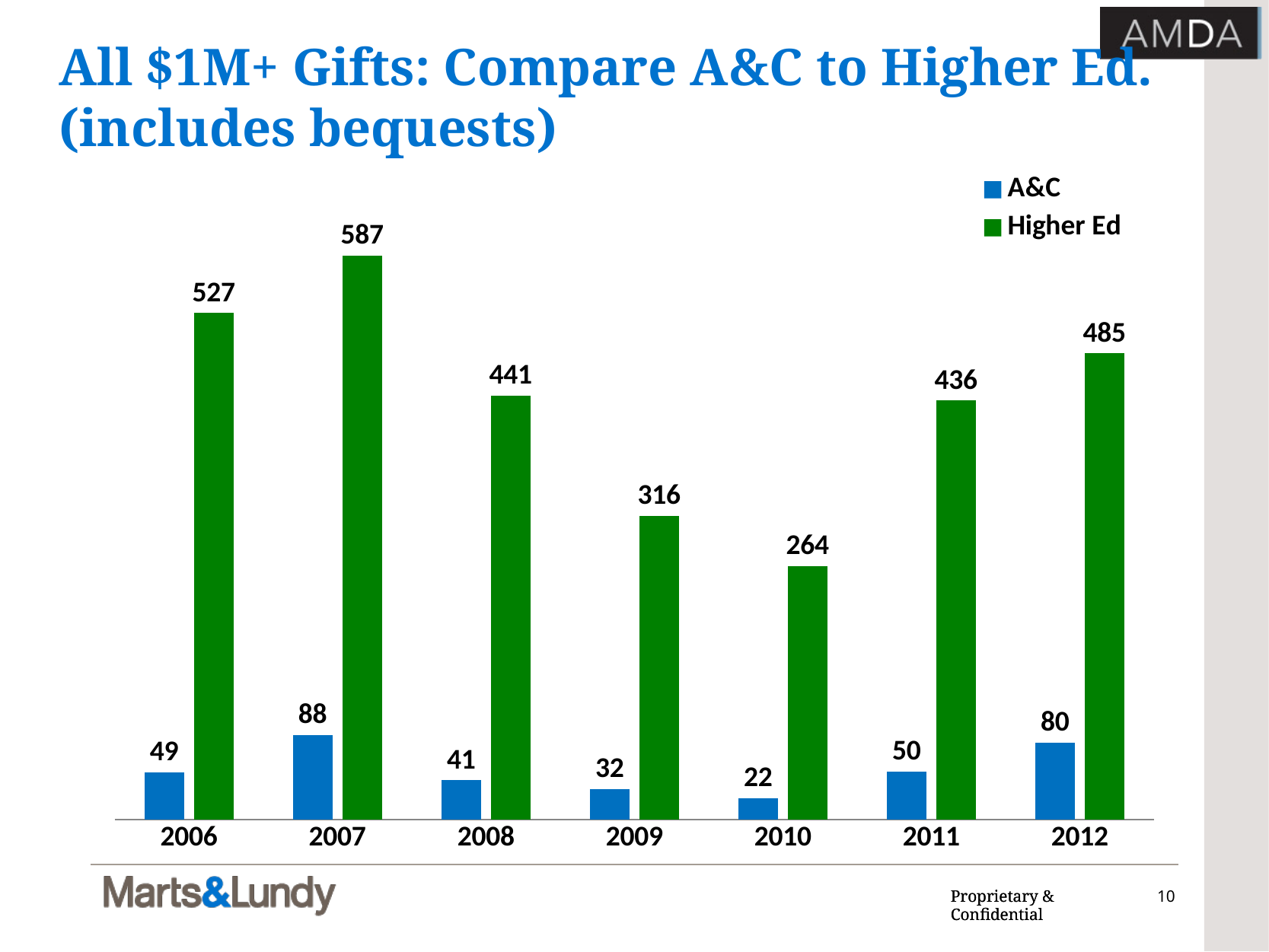
What kind of chart is shown on the slide? bar chart What is the Higher Ed value for 2007? 587 What is the A&C value for 2010? 22 Which year has the highest Higher Ed value? 2007 Which is larger, the A&C value for 2007 or the A&C value for 2012? 2007 Do the Higher Ed values rise or fall from 2007 to 2010? fall How many years are shown on the x axis? 7 Which year has the lowest A&C value? 2010 What is the A&C value for 2012? 80 What colour are the Higher Ed bars? green What is the difference between the Higher Ed and A&C values in 2006? 478 How many series does the legend list? 2